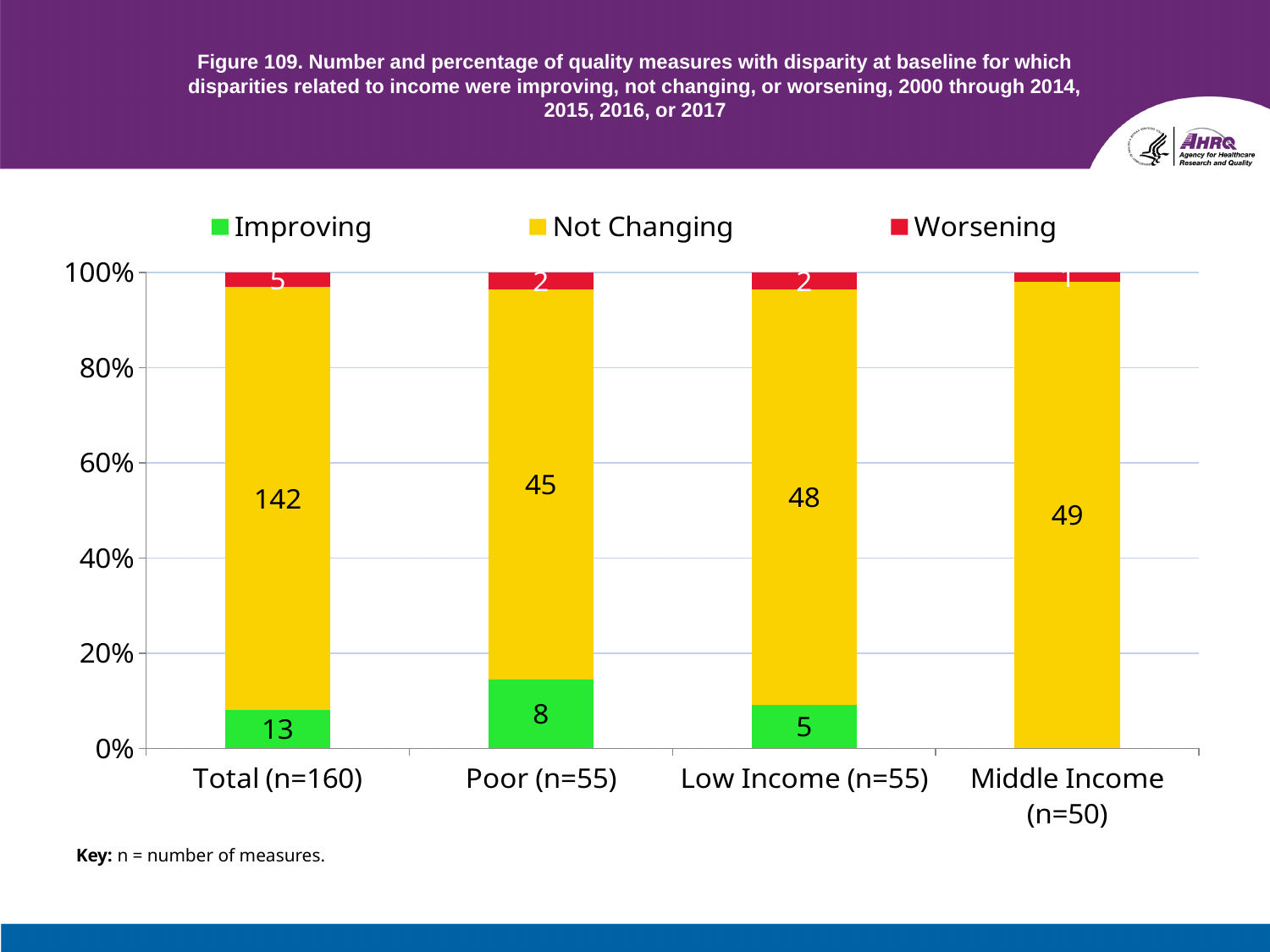
How many series does the legend list? 3 What is the difference between the Improving values for Total (n=160) and Poor (n=55)? 5 What is the Improving value for Poor (n=55)? 8 What kind of chart is shown on the slide? Stacked bar chart Which category has the highest Not Changing value? Total (n=160) What is the Not Changing value for Total (n=160)? 142 Which is larger, the Improving value for Poor (n=55) or for Low Income (n=55)? Poor (n=55) What is the Not Changing value for Low Income (n=55)? 48 Among Poor, Low Income and Middle Income, which category has the lowest Not Changing value? Poor (n=55) What is the total number of measures in the Poor (n=55) bar, summing the Improving, Not Changing and Worsening labels? 55 How many categories are shown on the x axis? 4 What is the Worsening value for Middle Income (n=50)? 1